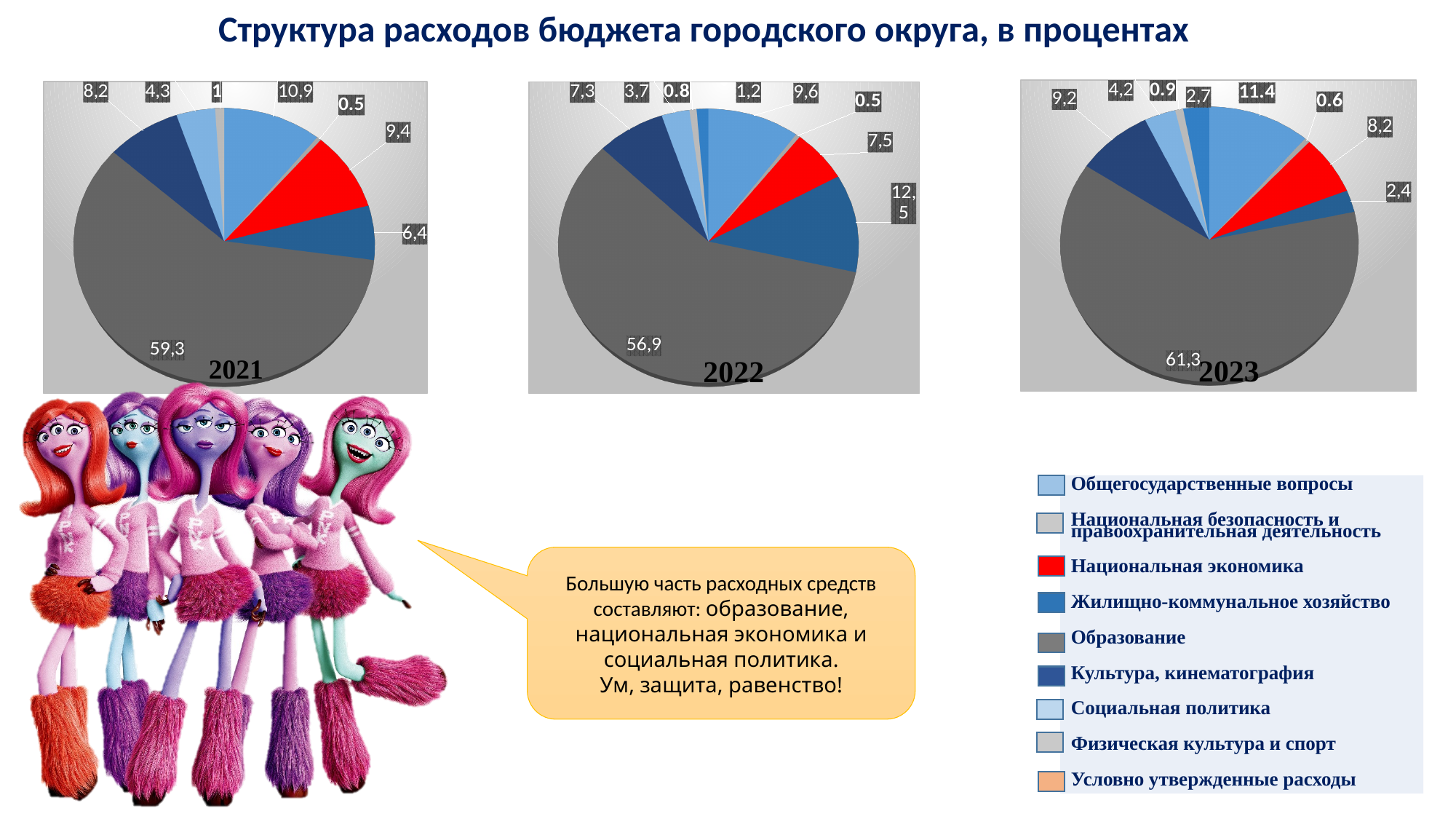
How many categories does the legend list? 9 Does the Национальная экономика (red slice) value rise or fall from the 2021 pie chart to the 2022 pie chart? Fall In the 2021 pie chart, what is the value for Национальная экономика (red slice)? 9,4 Is the Образование share larger in the 2021 pie chart or in the 2022 pie chart? 2021 In the 2022 pie chart, what is the value for Образование? 56,9 What is the title of the slide's charts? Структура расходов бюджета городского округа, в процентах What is the difference between the Образование value in the 2023 pie chart and in the 2022 pie chart? 4,4 In the 2023 pie chart, what is the value for Образование? 61,3 What type of charts are shown on the slide? Pie charts How many pie charts are on the slide? 3 In the 2023 pie chart, which category has the largest share? Образование In the 2021 pie chart, what is the value for Образование? 59,3